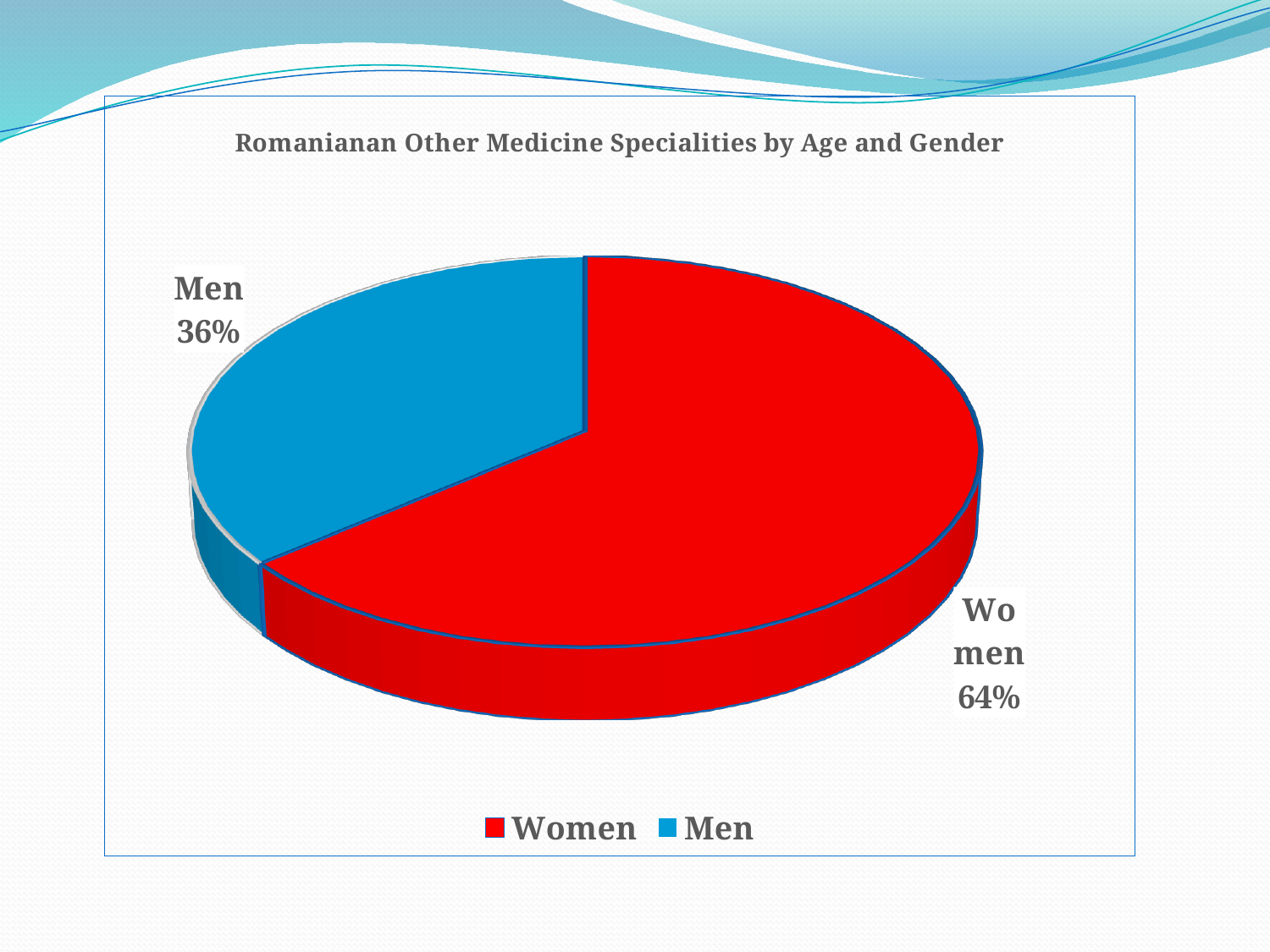
Which category has the largest share of the pie? Women How many entries does the legend list? 2 How many slices does the pie chart have? 2 Which share is larger, Women or Men? Women Which category has the smallest share of the pie? Men What is the difference in percentage points between the Women and Men shares? 28 What percentage of the pie is Men? 36% What percentage of the pie is Women? 64% What kind of chart is shown on the slide? Pie chart What is the title of the chart? Romanianan Other Medicine Specialities by Age and Gender What colour is the Women slice? Red